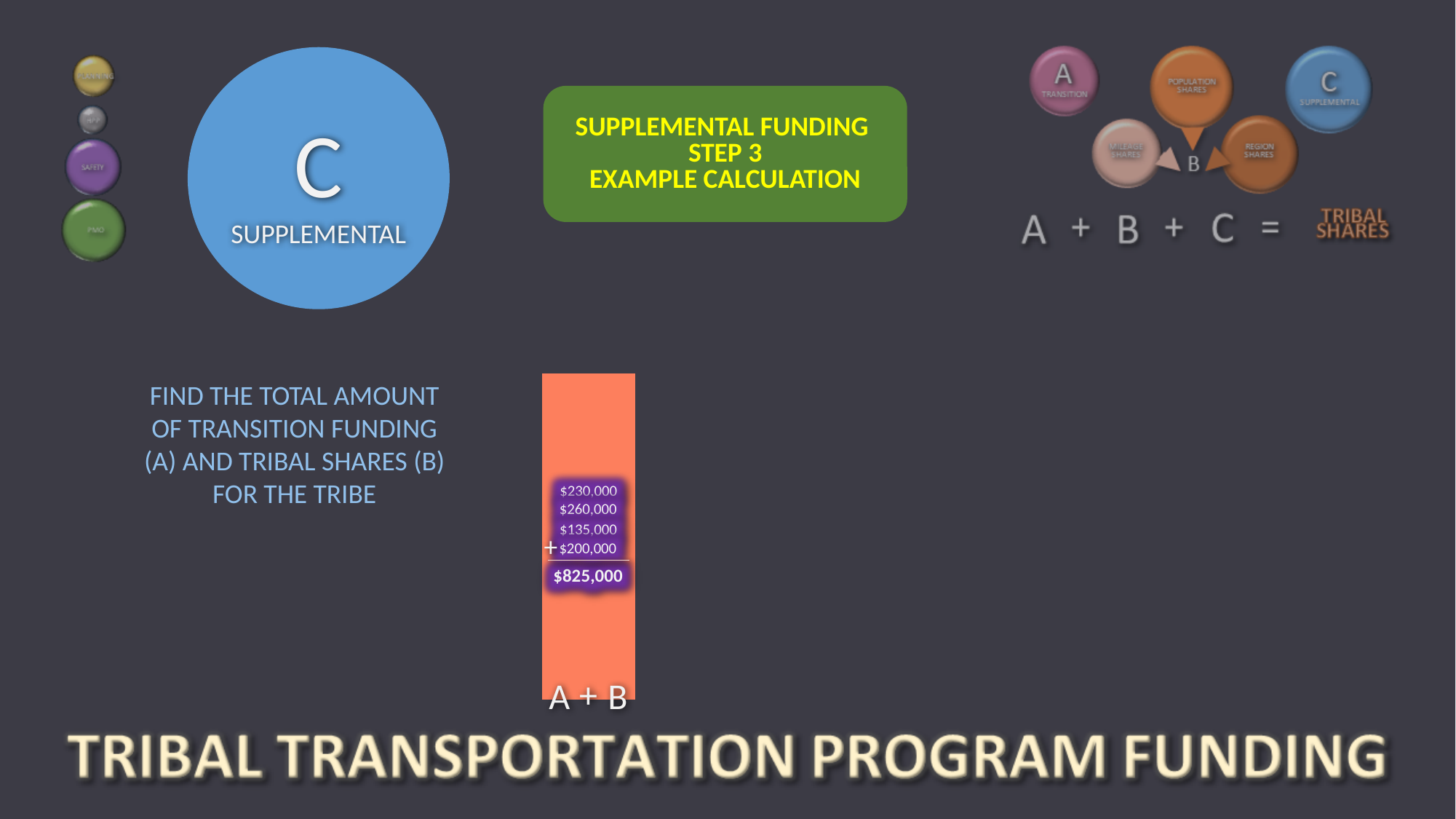
Which is larger in the A + B bar, $200,000 or $135,000? $200,000 What is the difference between the $260,000 and $230,000 amounts in the A + B bar? $30,000 What is the last amount added (after the plus sign) in the A + B bar? $200,000 What kind of chart is the orange A + B graphic? bar chart What is the label under the orange bar? A + B Which of the four amounts added in the A + B bar is the smallest? $135,000 Which of the four amounts added in the A + B bar is the largest? $260,000 What is the difference between the $230,000 and $135,000 amounts in the A + B bar? $95,000 What colour is the A + B bar? orange How many dollar amounts are added together inside the A + B bar? 4 What is the total shown at the bottom of the A + B bar? $825,000 What is the first amount listed in the A + B bar? $230,000